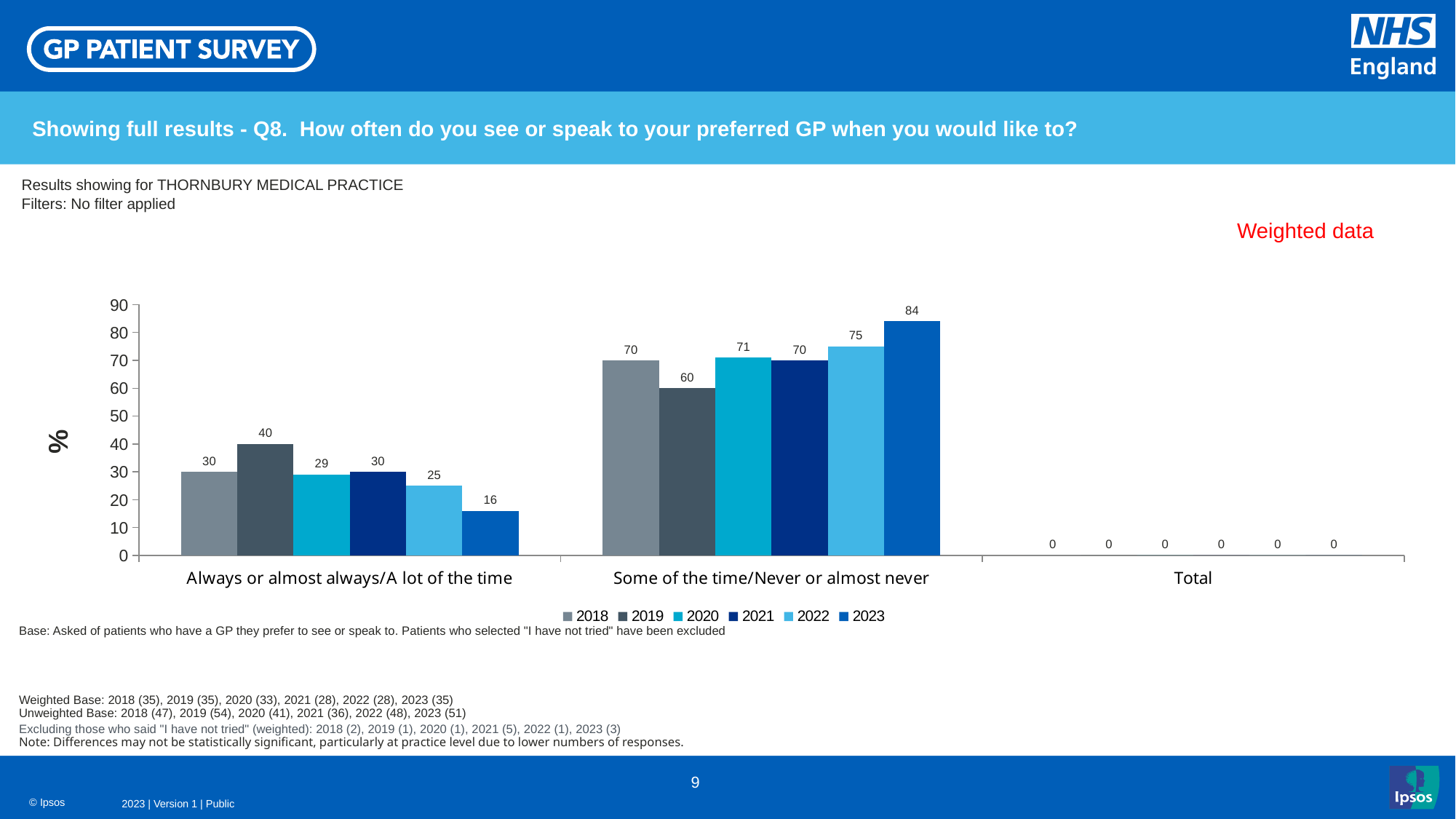
How many series does the legend list? 6 What is the difference between the 2023 and 2018 values in the 'Some of the time/Never or almost never' category? 14 Which year has the highest value in the 'Some of the time/Never or almost never' category? 2023 What is the label on the y axis? % What is the value for 2019 in the 'Some of the time/Never or almost never' category? 60 How many categories are shown on the x axis? 3 What kind of chart is shown on the slide? Bar chart What is the value shown for every year in the 'Total' category? 0 What is the value for 2023 in the 'Always or almost always/A lot of the time' category? 16 Which is larger: the 2019 value or the 2021 value in the 'Always or almost always/A lot of the time' category? 2019 Which year has the lowest value in the 'Always or almost always/A lot of the time' category? 2023 What is the value for 2022 in the 'Always or almost always/A lot of the time' category? 25